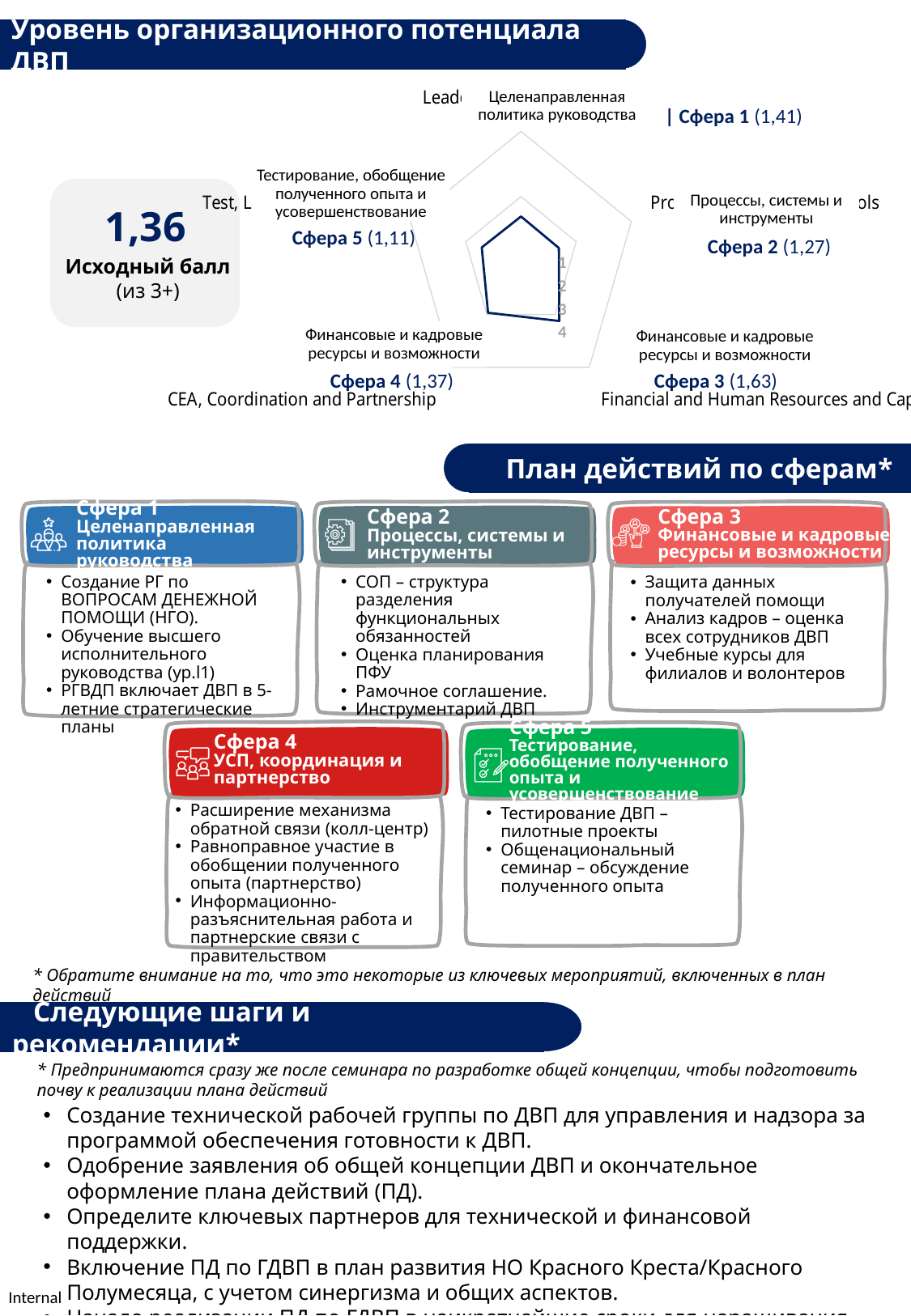
Is the value for Сфера 4 on the radar chart greater or less than 2? less What is the difference between the values of Сфера 3 and Сфера 5 on the radar chart? 0,52 What is the value shown for Сфера 1 (Целенаправленная политика руководства) on the radar chart? 1,41 How many spheres (axes) does the radar chart have? 5 What kind of chart is shown at the top of the slide under the title 'Уровень организационного потенциала ДВП'? Radar chart Which sphere has the highest value on the radar chart? Сфера 3 (1,63) What is the value shown for Сфера 5 (Тестирование, обобщение полученного опыта и усовершенствование) on the radar chart? 1,11 Which sphere has the lowest value on the radar chart? Сфера 5 (1,11) What is the value shown for Сфера 3 (Финансовые и кадровые ресурсы и возможности) on the radar chart? 1,63 What overall score (Исходный балл) is shown next to the radar chart? 1,36 (из 3+) Which has a larger value on the radar chart, Сфера 1 or Сфера 2? Сфера 1 What is the value shown for Сфера 2 (Процессы, системы и инструменты) on the radar chart? 1,27